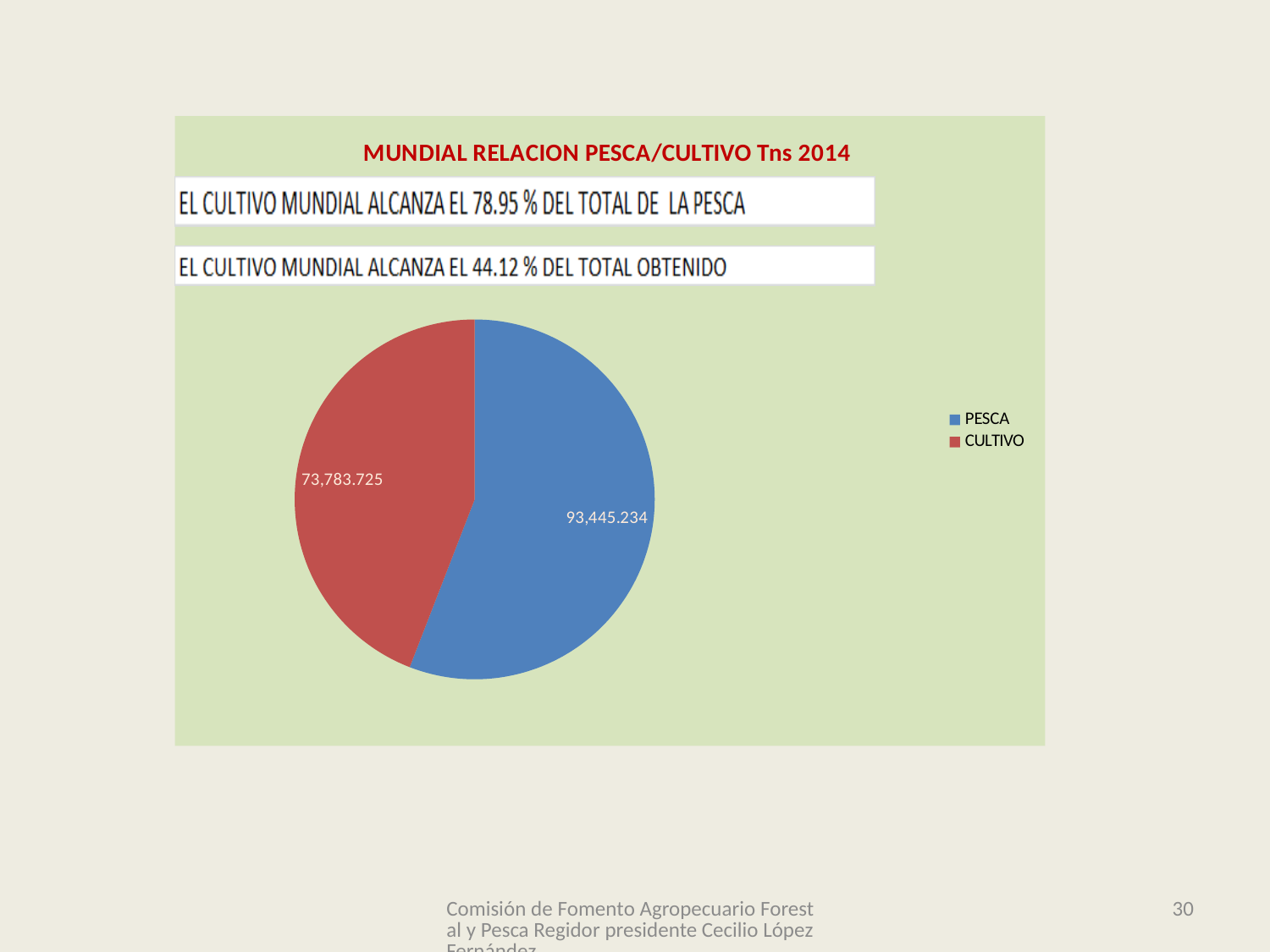
Which slice of the pie chart is the smallest? CULTIVO What is the difference between the PESCA value and the CULTIVO value? 19,661.509 Which slice of the pie chart is the largest? PESCA How many slices does the pie chart have? 2 Which is larger, the value for PESCA or the value for CULTIVO? PESCA What type of chart is shown on the slide? pie chart What share of the pie does the CULTIVO slice represent? 44.12% How many entries does the legend list? 2 What is the value for PESCA in the pie chart? 93,445.234 What is the title of the chart? MUNDIAL RELACION PESCA/CULTIVO Tns 2014 What is the value for CULTIVO in the pie chart? 73,783.725 What is the total of the two values shown in the pie chart? 167,228.959